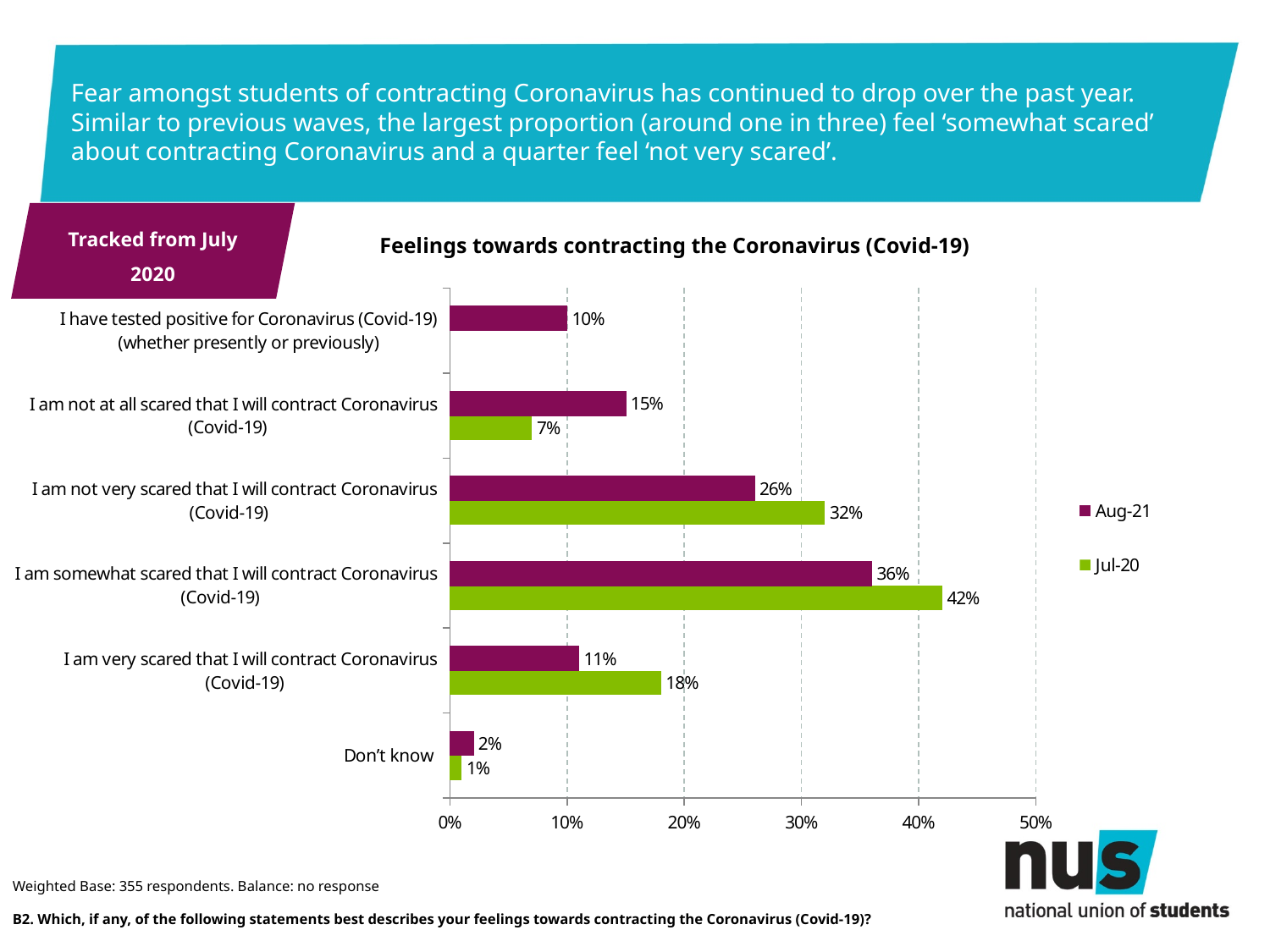
How many categories are shown on the chart? 6 Is the Jul-20 value for 'I am somewhat scared that I will contract Coronavirus (Covid-19)' greater or less than 40%? greater Which category has the lowest Aug-21 value? Don't know For 'I am not at all scared that I will contract Coronavirus (Covid-19)', which is larger: the Aug-21 value or the Jul-20 value? Aug-21 What is the Aug-21 value for 'I have tested positive for Coronavirus (Covid-19) (whether presently or previously)'? 10% How many series does the legend list? 2 Which category has the highest Jul-20 value? I am somewhat scared that I will contract Coronavirus (Covid-19) What is the Jul-20 value for 'I am not very scared that I will contract Coronavirus (Covid-19)'? 32% What kind of chart is shown on the slide? Bar chart What is the title of the chart? Feelings towards contracting the Coronavirus (Covid-19) What is the difference between the Jul-20 and Aug-21 values for 'I am very scared that I will contract Coronavirus (Covid-19)'? 7% What is the Aug-21 value for 'I am somewhat scared that I will contract Coronavirus (Covid-19)'? 36%